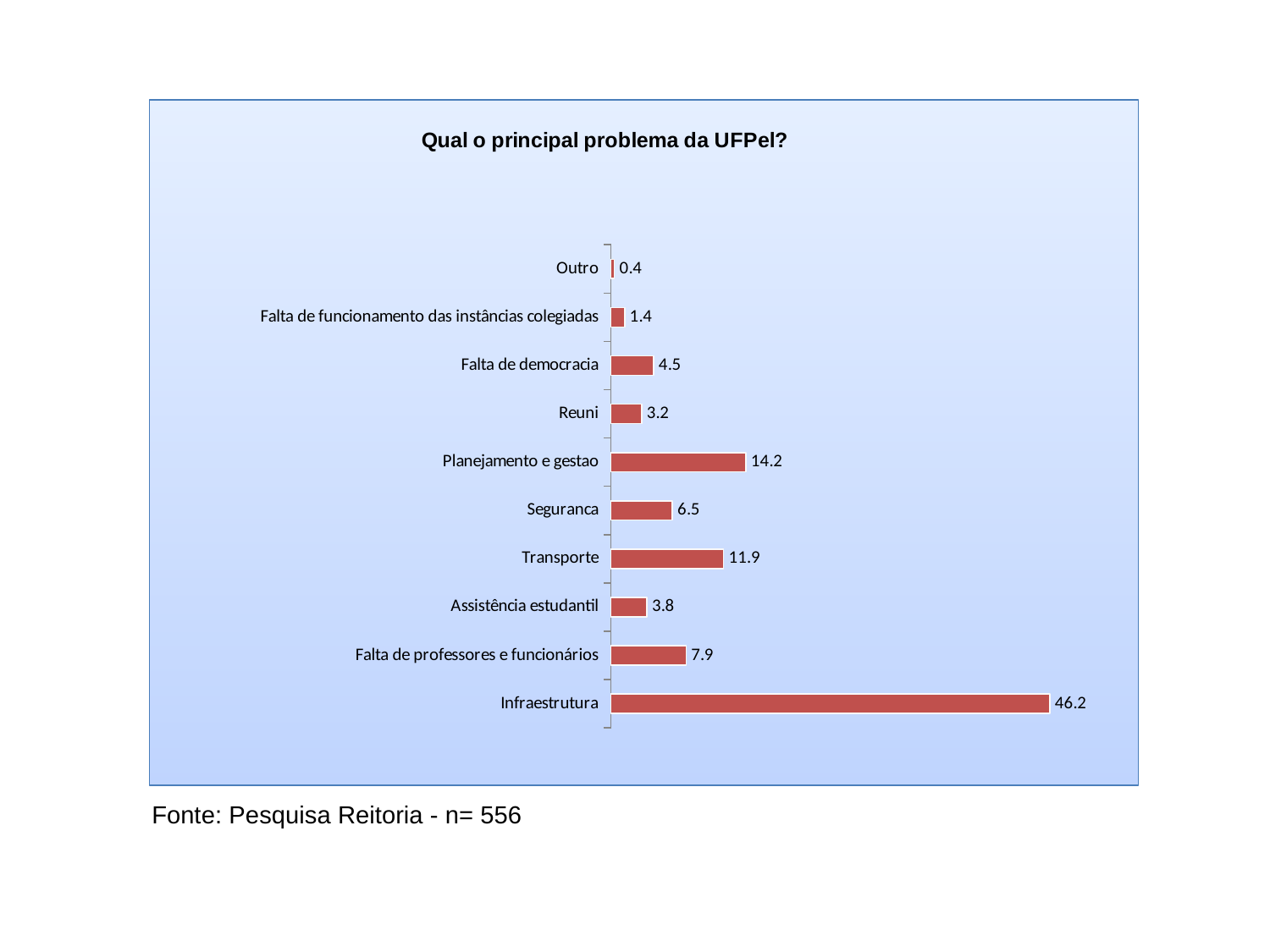
What kind of chart is shown on the slide? Bar chart What is the difference between the values for Transporte and Seguranca? 5.4 What is the value for Planejamento e gestao? 14.2 What is the title of the chart? Qual o principal problema da UFPel? What is the value for Transporte? 11.9 Which is larger, the value for Falta de professores e funcionários or the value for Seguranca? Falta de professores e funcionários What is the difference between the values for Infraestrutura and Planejamento e gestao? 32.0 What is the value for Falta de democracia? 4.5 Which category has the highest value? Infraestrutura How many categories are shown in the chart? 10 What is the value for Infraestrutura? 46.2 Which category has the lowest value? Outro